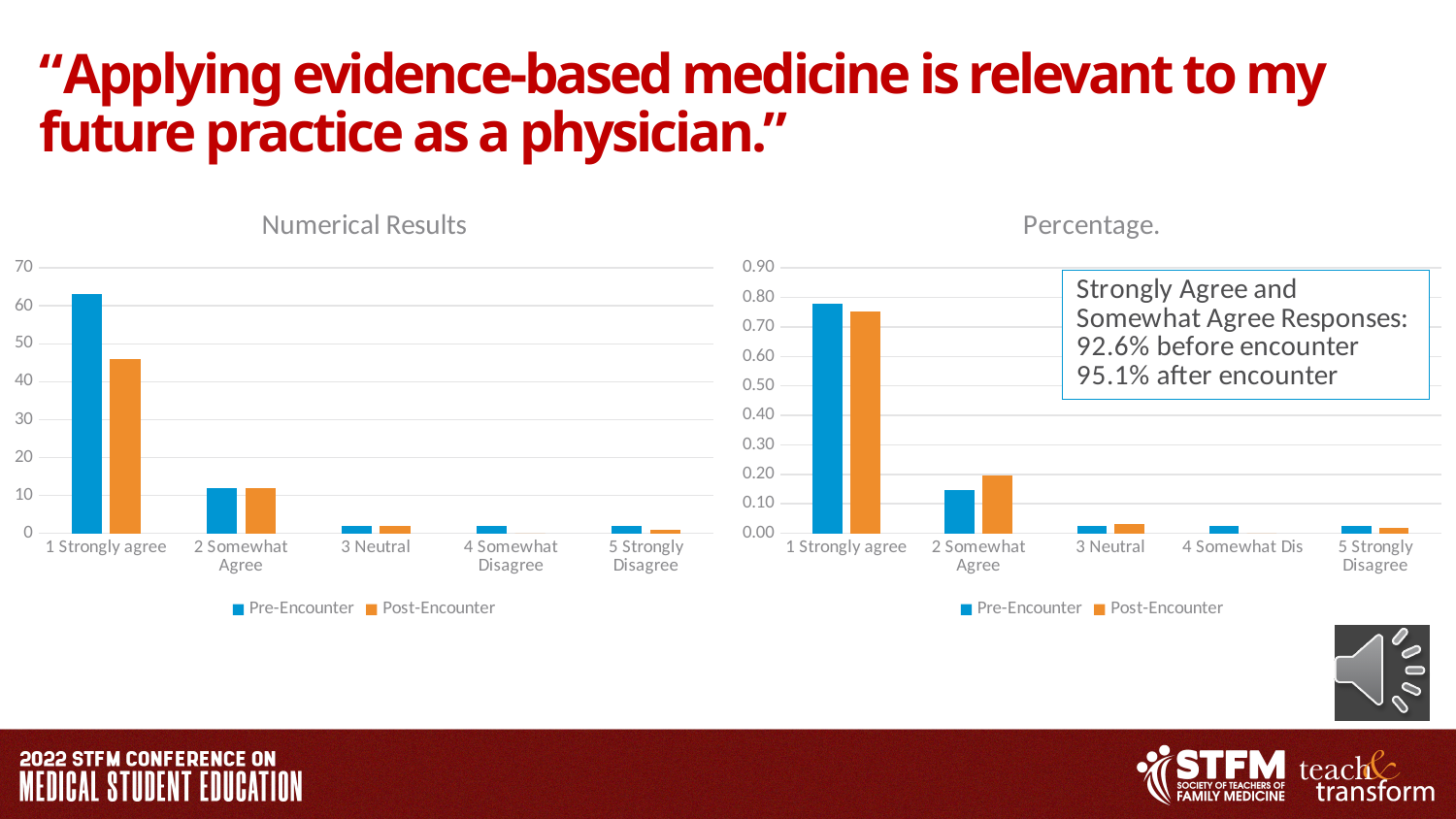
In the Numerical Results chart, do the Pre-Encounter values generally rise or fall from 1 Strongly agree to 5 Strongly Disagree? fall In the Numerical Results chart, which is larger for 1 Strongly agree, the Pre-Encounter or the Post-Encounter value? Pre-Encounter In the Numerical Results chart, is the Pre-Encounter value for 1 Strongly agree greater or less than 60? greater What kind of chart is the Numerical Results chart? bar chart What are the two legend entries in the Percentage chart? Pre-Encounter and Post-Encounter In the Percentage chart, is the Post-Encounter value for 2 Somewhat Agree greater or less than 0.30? less In the Numerical Results chart, which category has the highest Pre-Encounter value? 1 Strongly agree In the Percentage chart, is the Pre-Encounter value for 1 Strongly agree greater or less than 0.70? greater In the Percentage chart, which is larger for 2 Somewhat Agree, the Pre-Encounter or the Post-Encounter value? Post-Encounter How many series does the legend of the Numerical Results chart list? 2 How many categories are shown on the x axis of the Percentage chart? 5